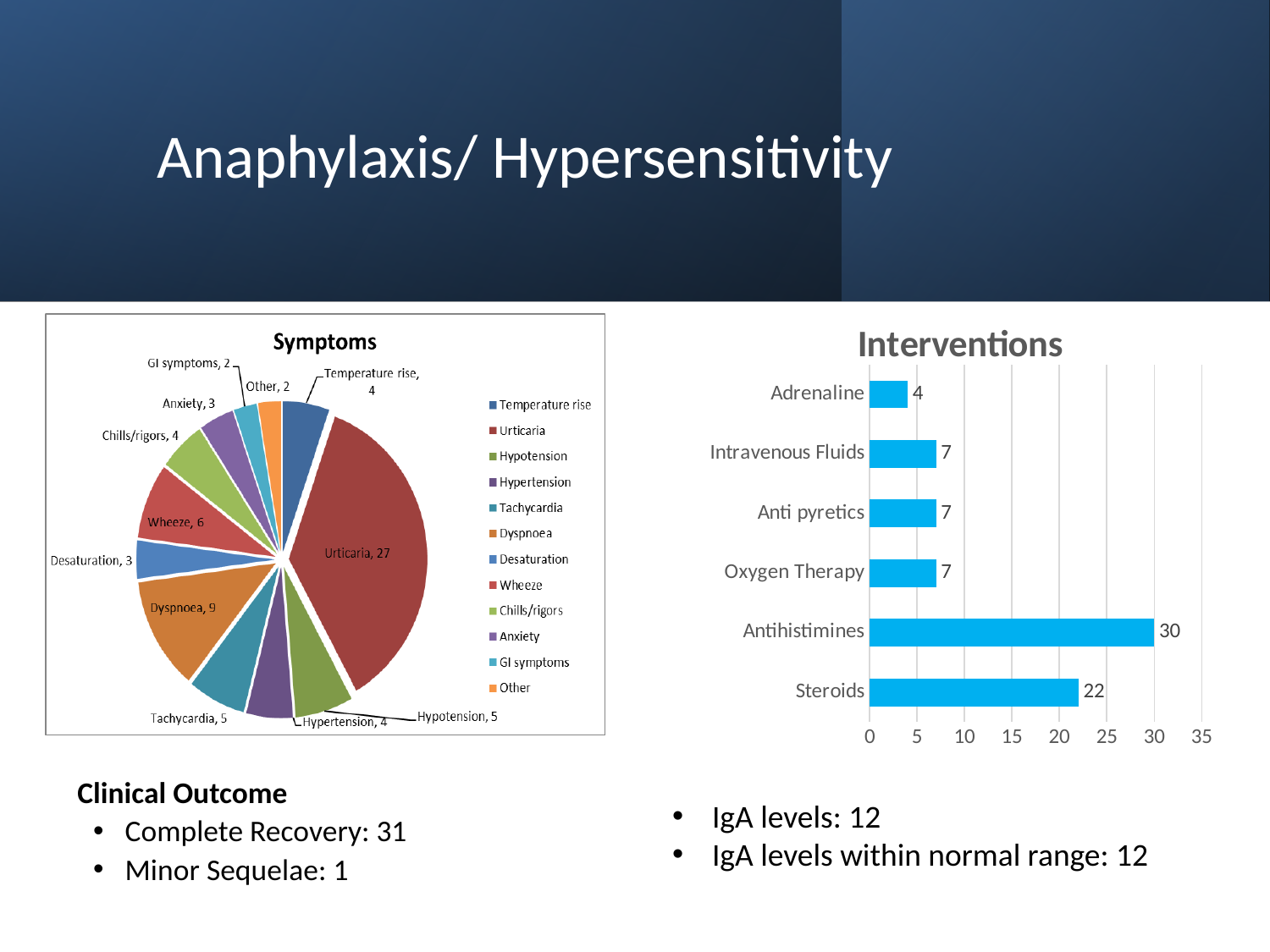
In the Interventions chart, what is the value for Steroids? 22 In the Interventions chart, which intervention has the lowest value? Adrenaline In the Symptoms pie chart, how many symptom categories are listed in the legend? 12 In the Interventions chart, what is the difference between Antihistimines and Steroids? 8 In the Interventions chart, what is the value for Antihistimines? 30 In the Symptoms pie chart, which symptom has the largest slice? Urticaria What kind of chart is the Interventions chart? Bar chart In the Interventions chart, how many interventions are shown? 6 In the Symptoms pie chart, what is the difference between Dyspnoea and Wheeze? 3 In the Symptoms pie chart, which is larger, Wheeze or Desaturation? Wheeze In the Symptoms pie chart, what is the value for Dyspnoea? 9 In the Symptoms pie chart, what is the value for Urticaria? 27